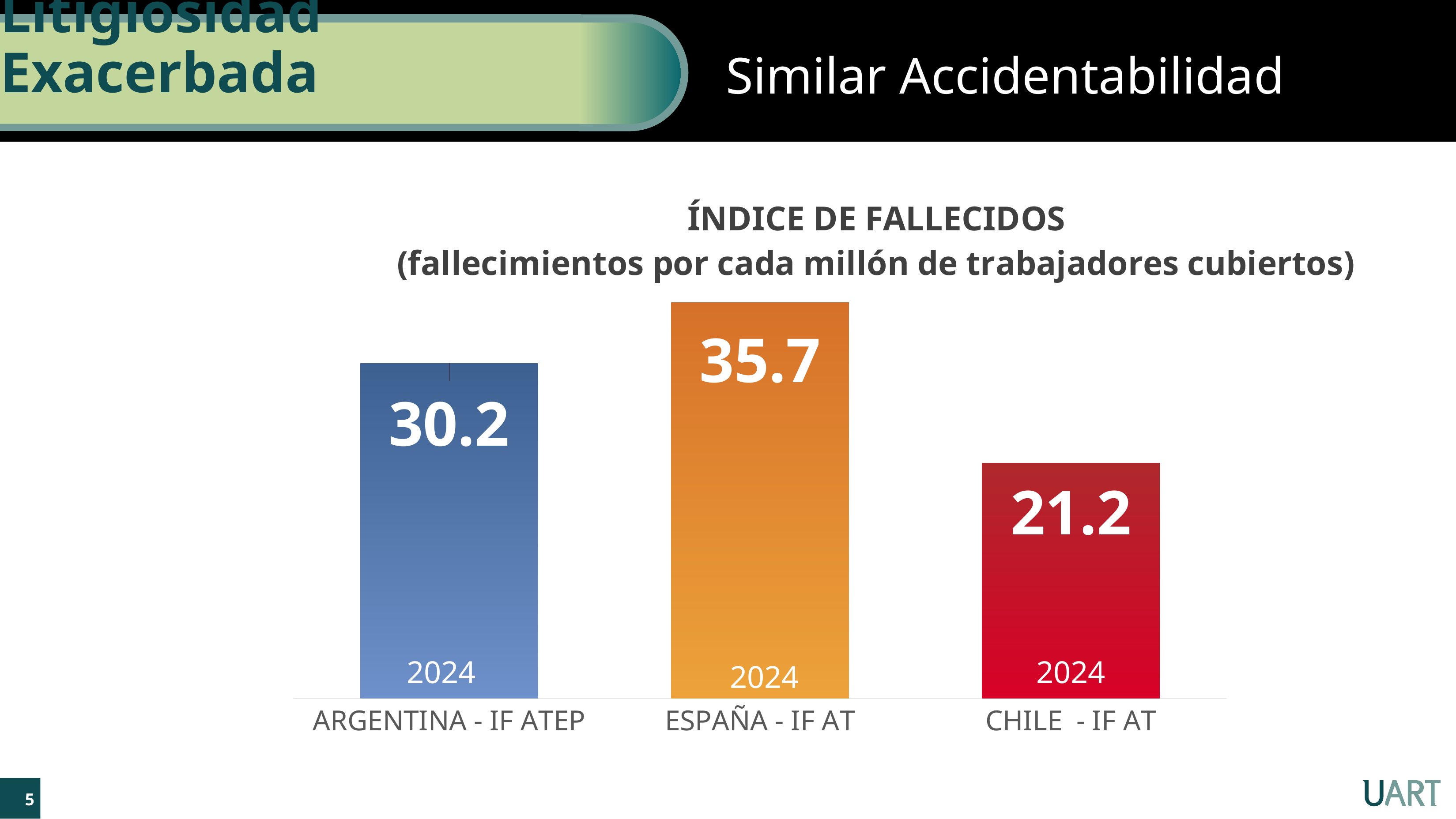
Which year is labelled on each bar of the chart? 2024 What is the difference between the values for ARGENTINA - IF ATEP and CHILE - IF AT? 9.0 What is the value for CHILE - IF AT? 21.2 What is the value for ARGENTINA - IF ATEP? 30.2 Which category has the lowest value? CHILE - IF AT Which is larger, the value for ARGENTINA - IF ATEP or the value for CHILE - IF AT? ARGENTINA - IF ATEP What is the difference between the values for ESPAÑA - IF AT and ARGENTINA - IF ATEP? 5.5 How many categories are shown in the chart? 3 Which category has the highest value? ESPAÑA - IF AT What kind of chart is shown on the slide? bar chart What is the title of the chart? ÍNDICE DE FALLECIDOS (fallecimientos por cada millón de trabajadores cubiertos) What is the value for ESPAÑA - IF AT? 35.7